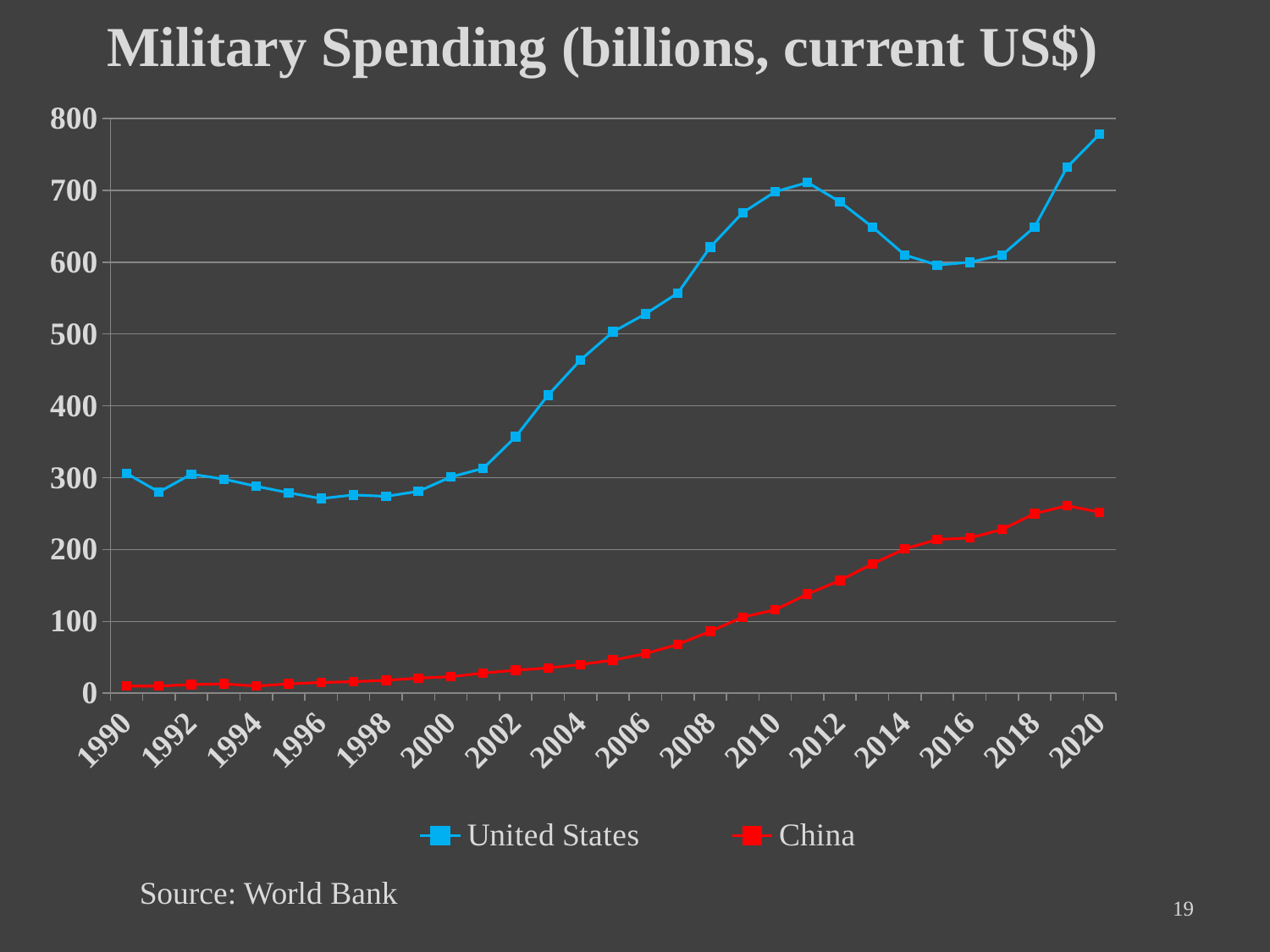
Is the value for China in 2020 greater or less than 200? greater Which series has the higher value in 2020, United States or China? United States How many series does the legend list? 2 Is the value for the United States in 1990 greater or less than 400? less Is the value for the United States in 2020 greater or less than 700? greater Which series is drawn in red? China Does the China series generally rise or fall from 1990 to 2019? rise What is the title of the chart? Military Spending (billions, current US$) In which year does the United States series reach its highest value? 2020 What kind of chart is shown on the slide? line chart